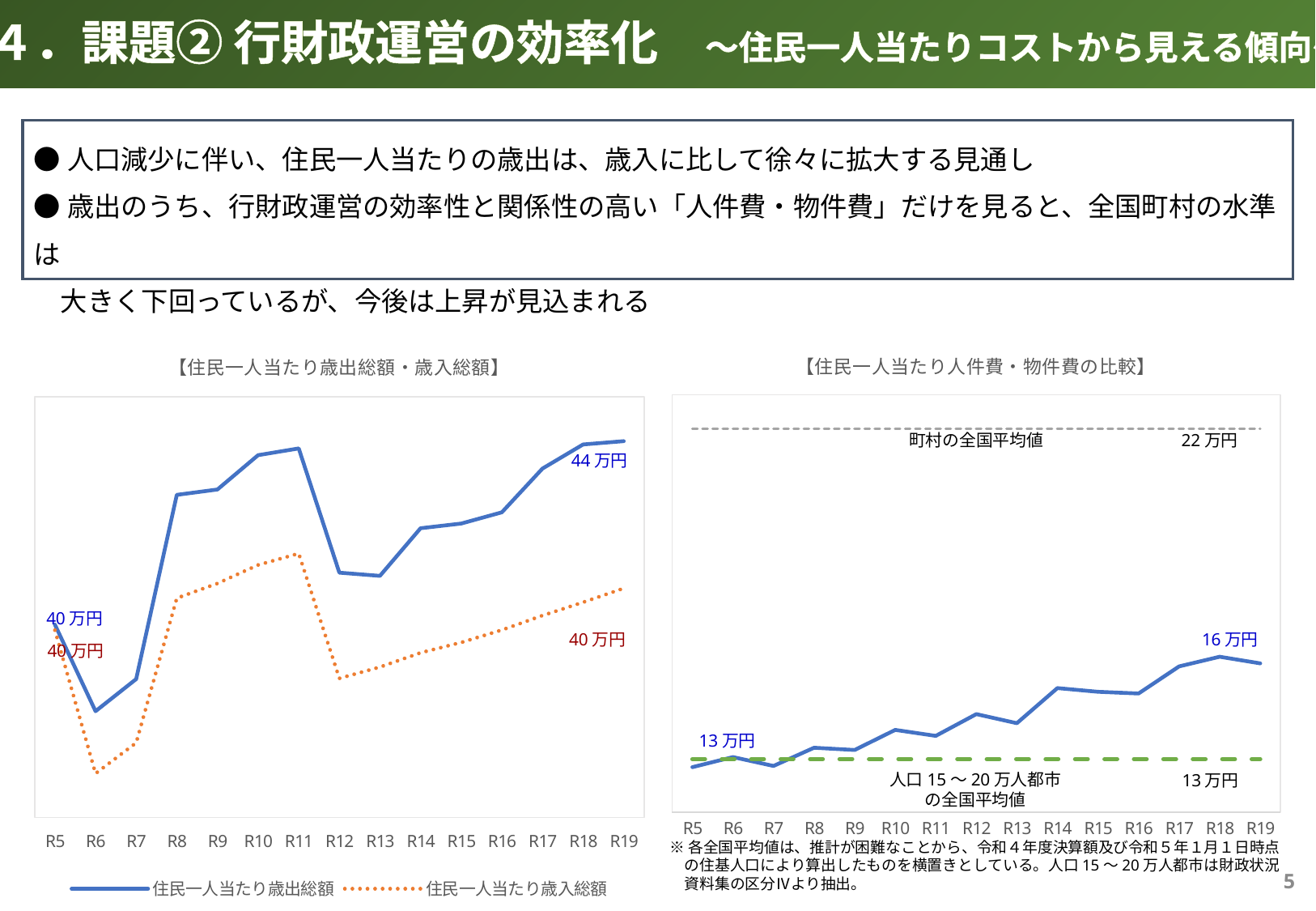
In the left chart 【住民一人当たり歳出総額・歳入総額】, how many years are shown on the x axis? 15 In the left chart 【住民一人当たり歳出総額・歳入総額】, what is the difference between 歳出総額 and 歳入総額 at R19? 4万円 In the right chart 【住民一人当たり人件費・物件費の比較】, does the plotted line generally rise or fall from R5 to R19? rise In the left chart 【住民一人当たり歳出総額・歳入総額】, how many series does the legend list? 2 In the left chart 【住民一人当たり歳出総額・歳入総額】, what is the labelled value of 住民一人当たり歳入総額 at R19? 40万円 In the left chart 【住民一人当たり歳出総額・歳入総額】, which year has the lowest value for 住民一人当たり歳出総額? R6 In the right chart 【住民一人当たり人件費・物件費の比較】, what is the labelled value at R19? 16万円 What kind of chart is the left chart titled 【住民一人当たり歳出総額・歳入総額】? line chart In the right chart 【住民一人当たり人件費・物件費の比較】, what is the difference between 町村の全国平均値 and 人口15～20万人都市の全国平均値? 9万円 In the left chart 【住民一人当たり歳出総額・歳入総額】, what is the labelled value of 住民一人当たり歳出総額 at R19? 44万円 In the right chart 【住民一人当たり人件費・物件費の比較】, what is the value of 町村の全国平均値? 22万円 In the left chart 【住民一人当たり歳出総額・歳入総額】, which series is drawn as a dotted orange line? 住民一人当たり歳入総額